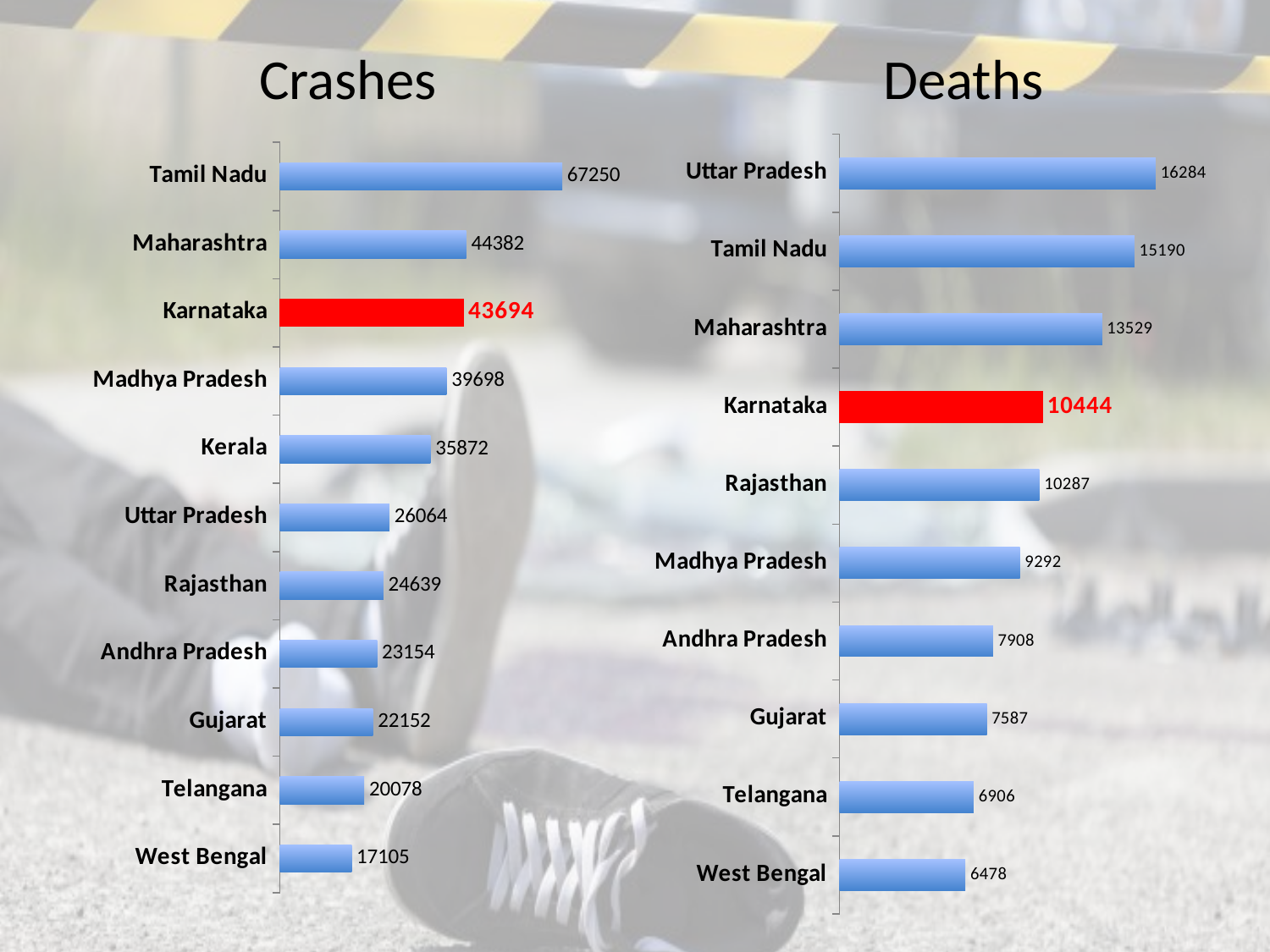
In the Crashes chart, what is the value for Karnataka? 43694 In the Crashes chart, which state's bar is coloured red? Karnataka In the Deaths chart, what is the difference between Uttar Pradesh and Karnataka? 5840 In the Crashes chart, which is larger, the value for Kerala or the value for Uttar Pradesh? Kerala In the Deaths chart, which state has the lowest value? West Bengal How many states are shown in the Crashes chart? 11 In the Deaths chart, which is larger, the value for Gujarat or the value for Telangana? Gujarat What kind of chart is the Deaths chart? Bar chart In the Crashes chart, what is the difference between Tamil Nadu and Maharashtra? 22868 In the Deaths chart, what is the value for Rajasthan? 10287 How many states are shown in the Deaths chart? 10 In the Crashes chart, which state has the highest value? Tamil Nadu